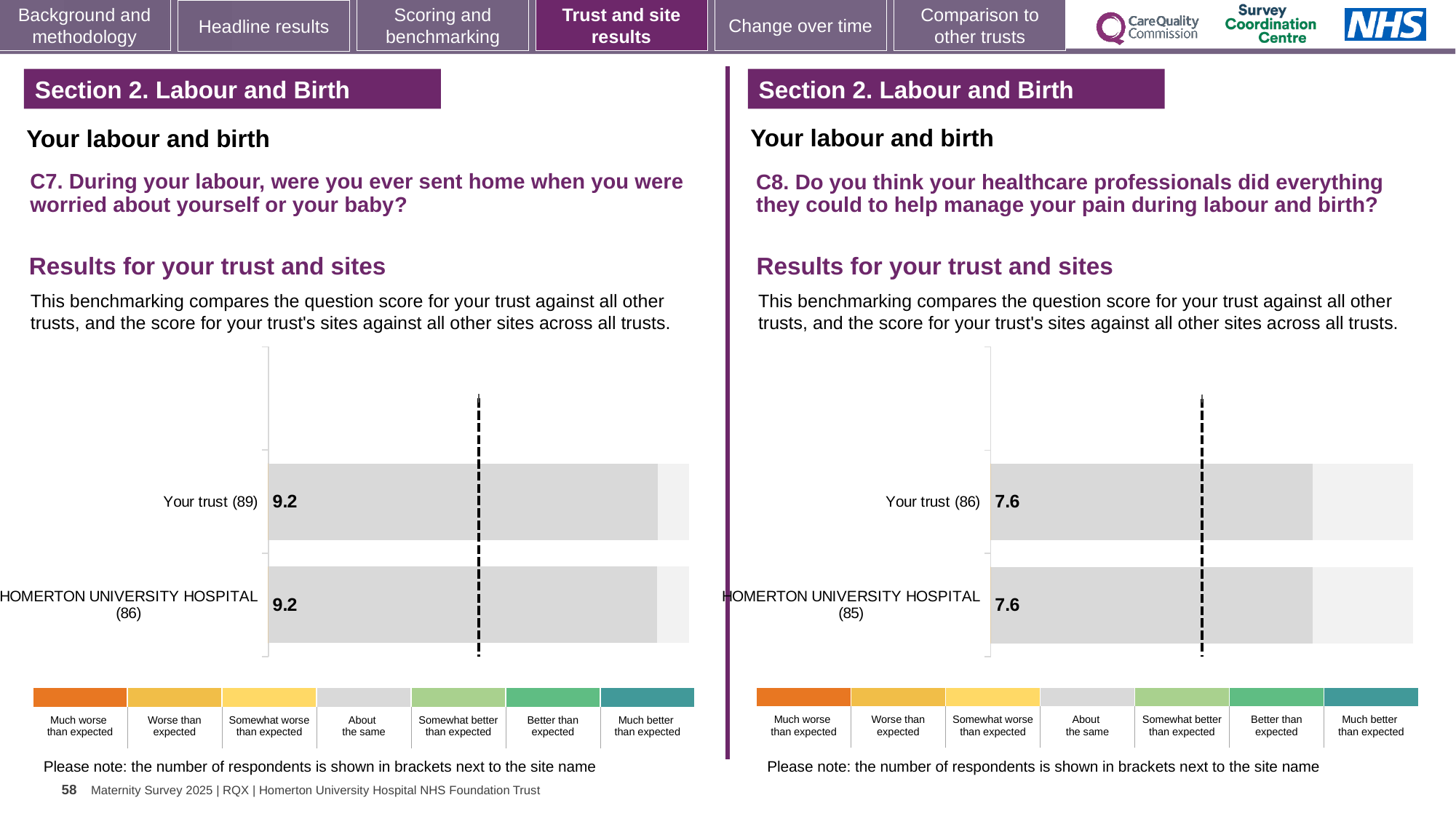
On the left chart (C7), what is the score for Homerton University Hospital? 9.2 On the right chart (C8), what is the difference between the score for Your trust and the score for Homerton University Hospital? 0.0 How many bars are plotted on the left chart (C7)? 2 On the left chart (C7), what is the difference between the score for Your trust and the score for Homerton University Hospital? 0.0 What kind of chart is used on the left (C7) to show the results? Bar chart How many bars are plotted on the right chart (C8)? 2 On the right chart (C8), what is the score for Homerton University Hospital? 7.6 On the left chart (C7), how many respondents are shown in brackets for Your trust? 89 On the right chart (C8), how many respondents are shown in brackets for Homerton University Hospital? 85 On the right chart (C8), what is the score for Your trust? 7.6 Is the Your trust score higher on the left chart (C7) or on the right chart (C8)? Left chart (C7) On the left chart (C7), what is the score for Your trust? 9.2